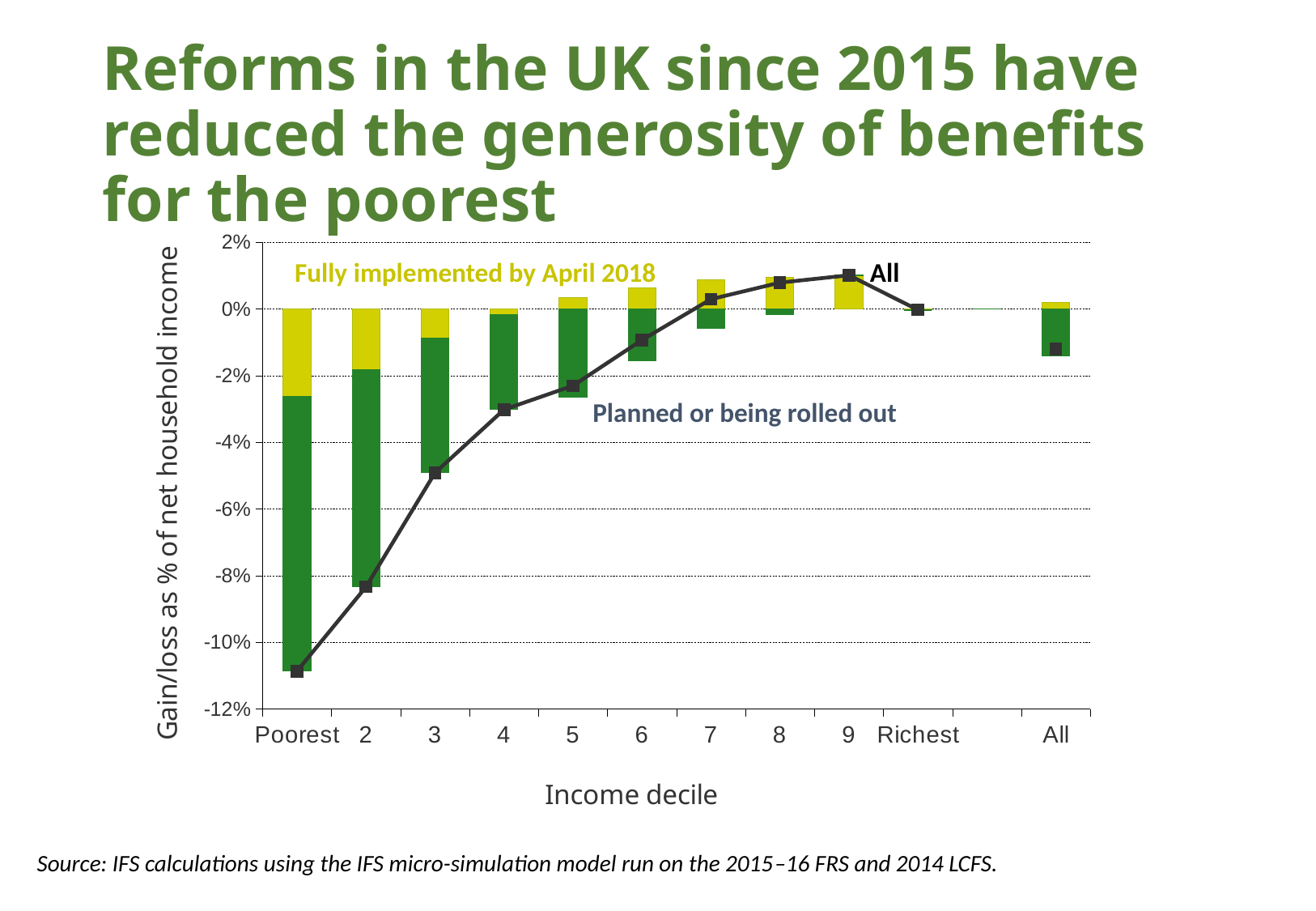
Which colour represents reforms 'Fully implemented by April 2018'? Yellow Is the 'All' line value for decile 9 greater or less than 0%? greater What kind of chart is shown on the slide? Stacked bar chart with a line Does the 'All' line rise or fall from the Poorest decile to decile 9? rise Is the 'All' line value for decile 4 greater or less than -2%? less What is the label of the y axis? Gain/loss as % of net household income Is the 'All' line value for the Poorest decile greater or less than -10%? less Which has the larger 'All' line value, the Poorest decile or the Richest decile? Richest Which income decile has the lowest value on the 'All' line? Poorest How many income decile categories are shown on the x axis, including 'All'? 11